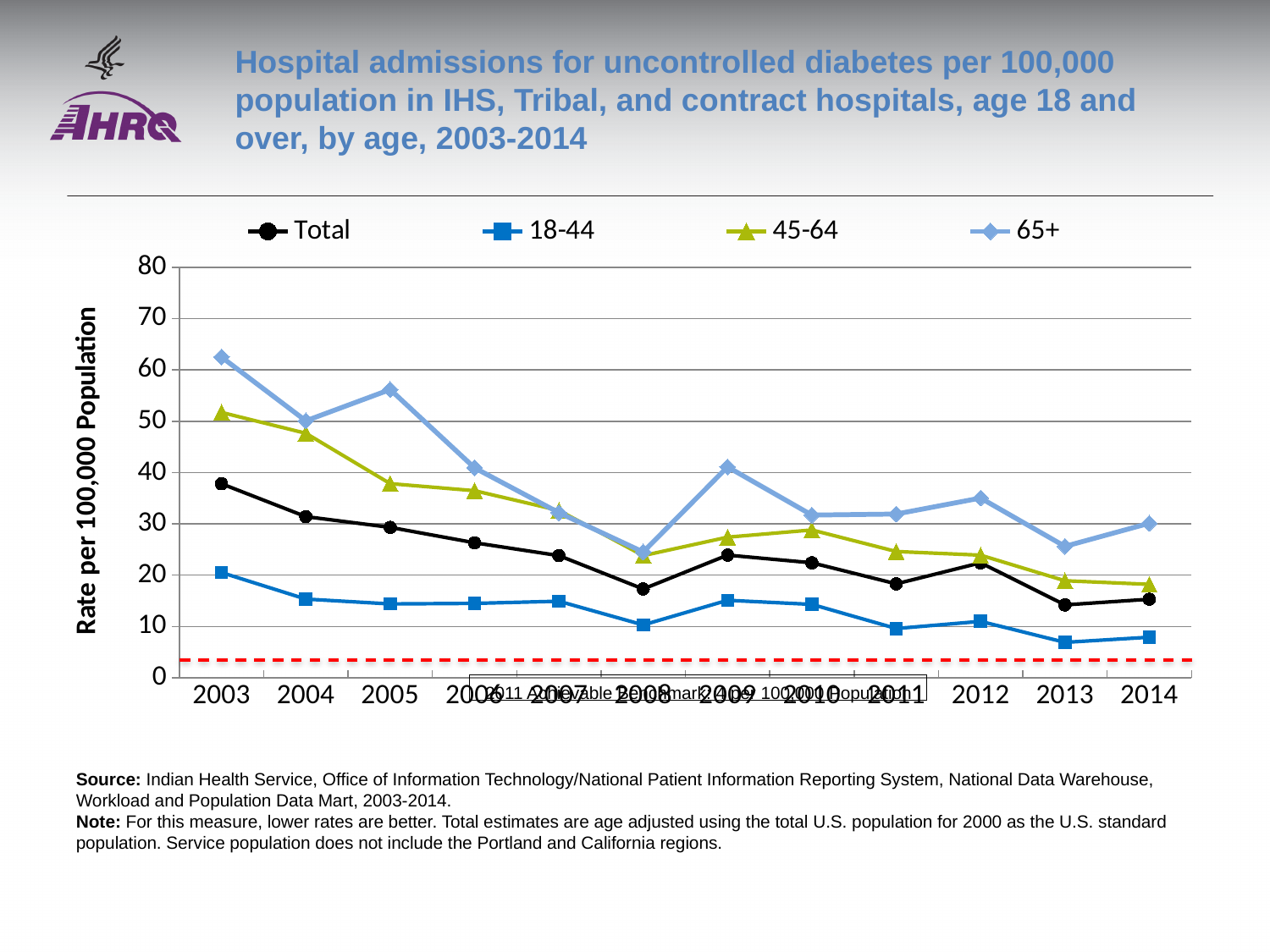
Which age group has the lowest rate across all years shown? 18-44 Is the value for 18-44 in 2013 greater or less than 10? less What is the label on the y axis? Rate per 100,000 Population How many years are plotted along the x axis? 12 In which year is the 65+ rate highest? 2003 How many series does the legend list? 4 Does the Total rate generally rise or fall from 2003 to 2014? Fall Which age group has the highest rate in 2003? 65+ Is the value for 65+ in 2003 greater or less than 60? greater What kind of chart is shown on the slide? Line chart Which is larger in 2005, the rate for 45-64 or the rate for Total? 45-64 Is the value for 65+ in 2005 greater or less than 50? greater